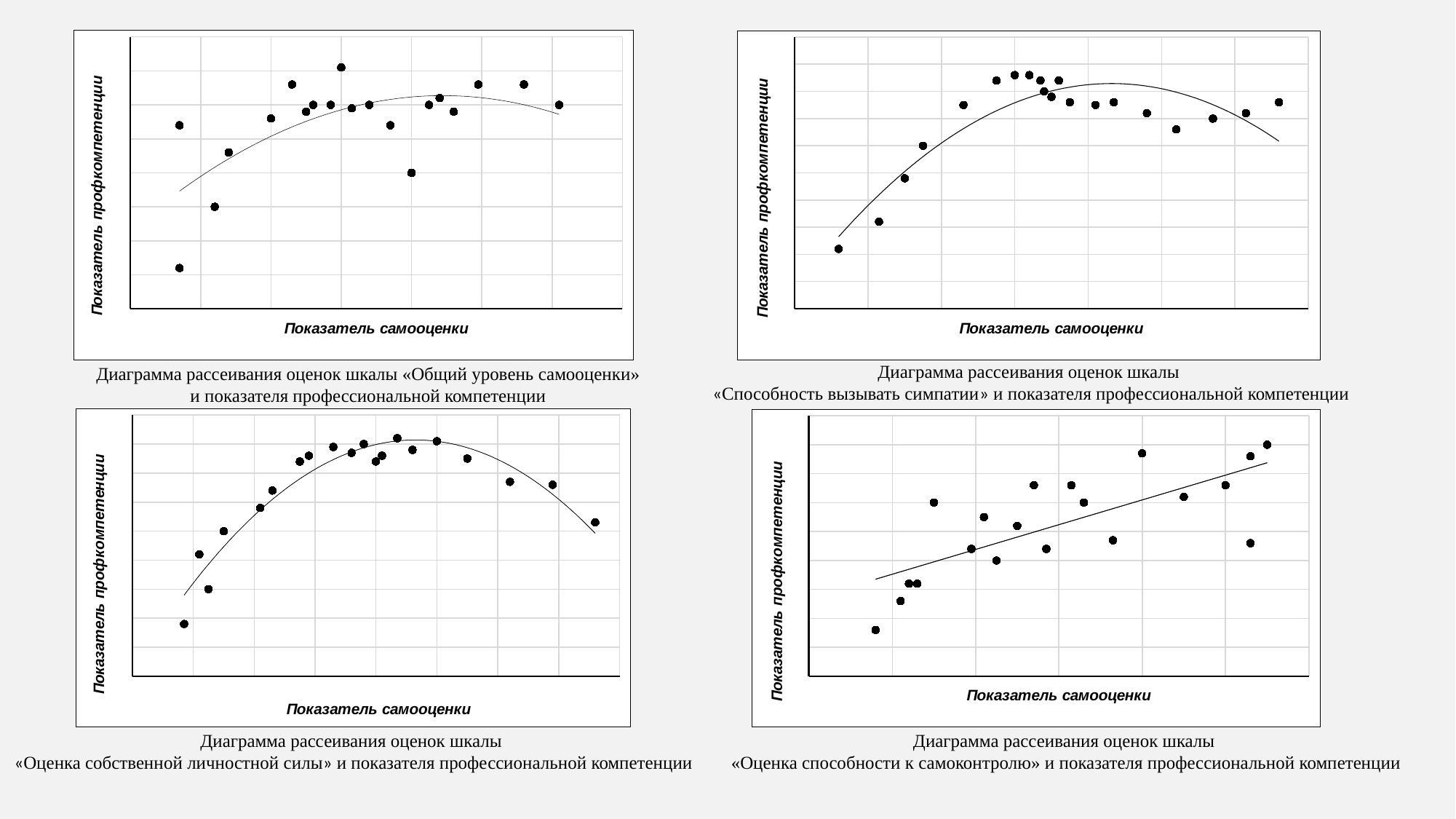
In the bottom-left chart («Оценка собственной личностной силы»), how does the fitted curve behave along the x axis? Rises, then falls In the top-right chart («Способность вызывать симпатии»), does the fitted curve rise or fall over the left half of the x axis? Rise How many data points are plotted in the bottom-left chart («Оценка собственной личностной силы»)? 20 In the bottom-right chart («Оценка способности к самоконтролю»), do the values generally rise or fall as the self-esteem score increases along the x axis? Rise In the bottom-left chart («Оценка собственной личностной силы»), is the lowest point located at the left end or the right end of the x axis? Left end How many charts are shown on the slide? 4 In the top-left chart («Общий уровень самооценки»), is the highest point located in the left third or the middle third of the x axis? Middle third What kind of chart is the top-left chart titled «Общий уровень самооценки»? Scatter chart What is the x-axis title of the bottom-right chart («Оценка способности к самоконтролю»)? Показатель самооценки How many data points are plotted in the bottom-right chart («Оценка способности к самоконтролю»)? 20 What is the y-axis title of the top-right chart («Способность вызывать симпатии»)? Показатель профкомпетенции Which of the four charts has a straight (linear) trend line rather than a curved one? The bottom-right chart («Оценка способности к самоконтролю»)